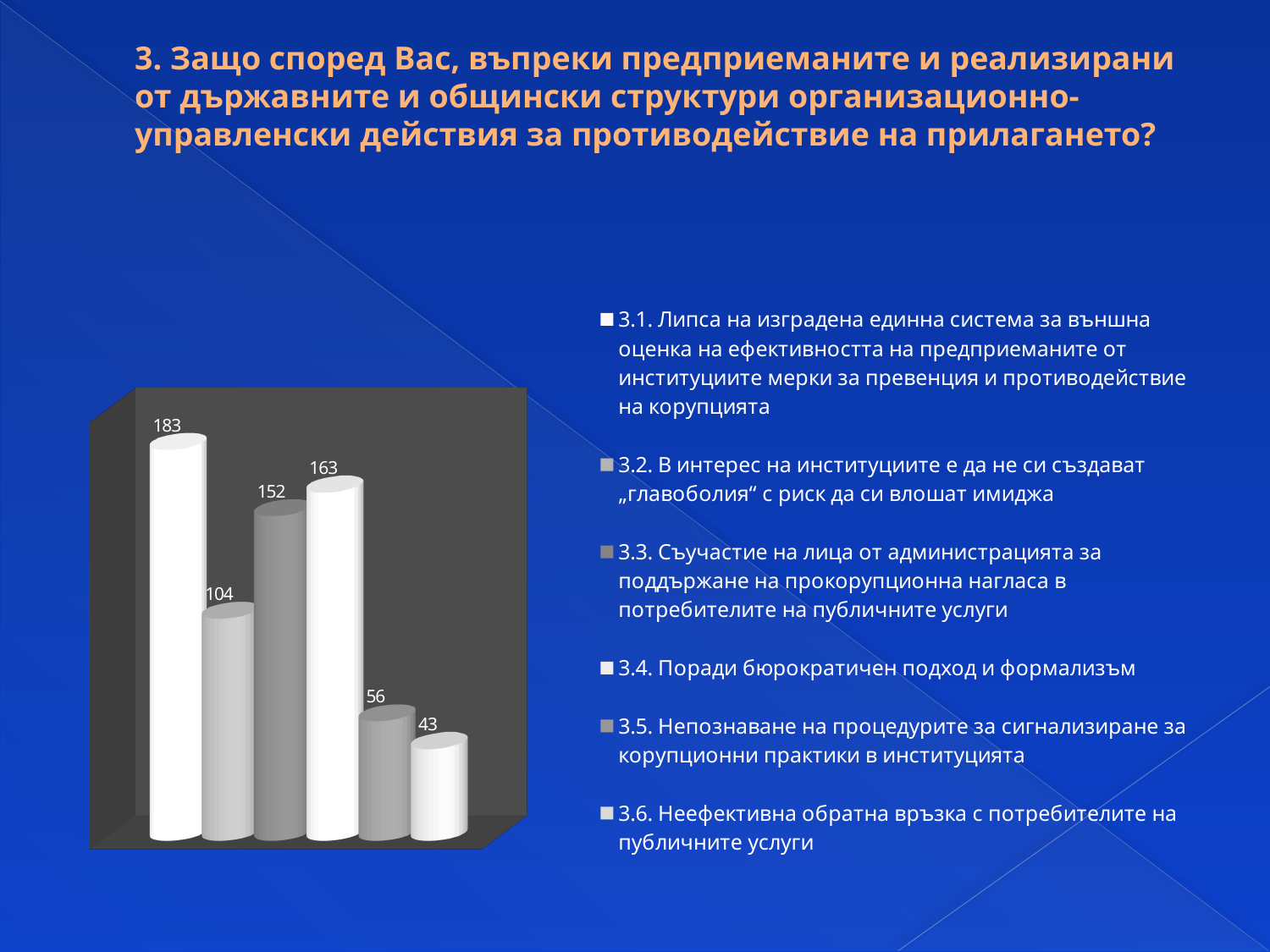
What value is shown for category 3.6 (Неефективна обратна връзка с потребителите на публичните услуги)? 43 Which is larger, the value for category 3.3 or the value for category 3.2? 3.3 What is the difference between the values for category 3.5 and category 3.6? 13 How many entries does the chart legend list? 6 Which category has the highest value in the chart? 3.1. Липса на изградена единна система за външна оценка на ефективността на предприеманите от институциите мерки за превенция и противодействие на корупцията What kind of chart is shown on the slide? bar chart What value is shown for category 3.2 (В интерес на институциите е да не си създават „главоболия“...)? 104 What value is shown for category 3.1 (Липса на изградена единна система за външна оценка...)? 183 How many bars are plotted in the chart? 6 What value is shown for category 3.4 (Поради бюрократичен подход и формализъм)? 163 Which category has the lowest value in the chart? 3.6. Неефективна обратна връзка с потребителите на публичните услуги What is the difference between the values for category 3.1 and category 3.4? 20